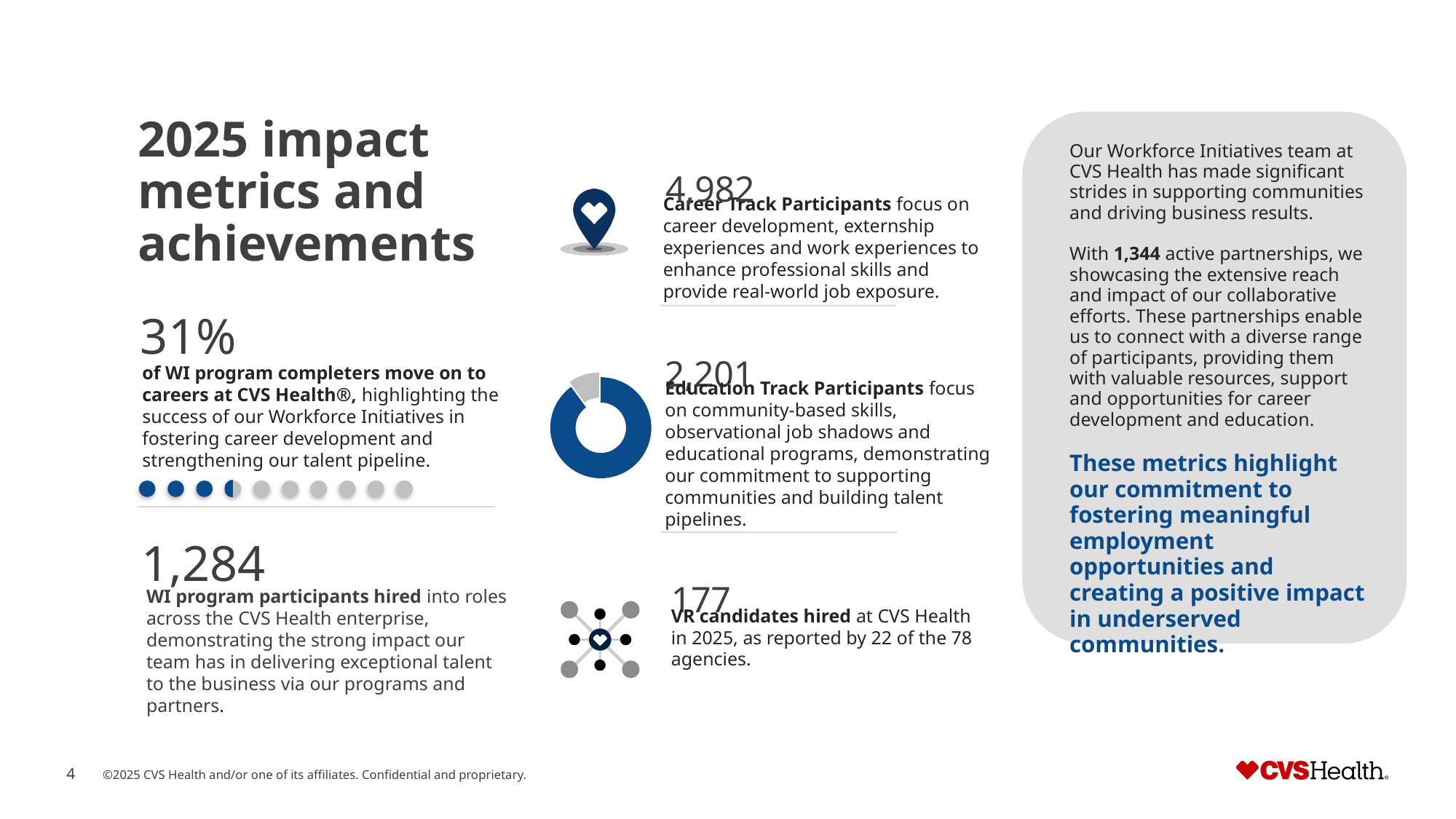
What percentage does the row of dots under the '31%' text represent? 31% What colour is the small segment of the donut chart? grey How many dots are in the row of dots below the '31%' statistic? 10 What kind of chart is shown to the left of the Education Track Participants text? donut chart In the donut chart, which segment is larger, the blue one or the grey one? the blue one How many segments does the donut chart have? 2